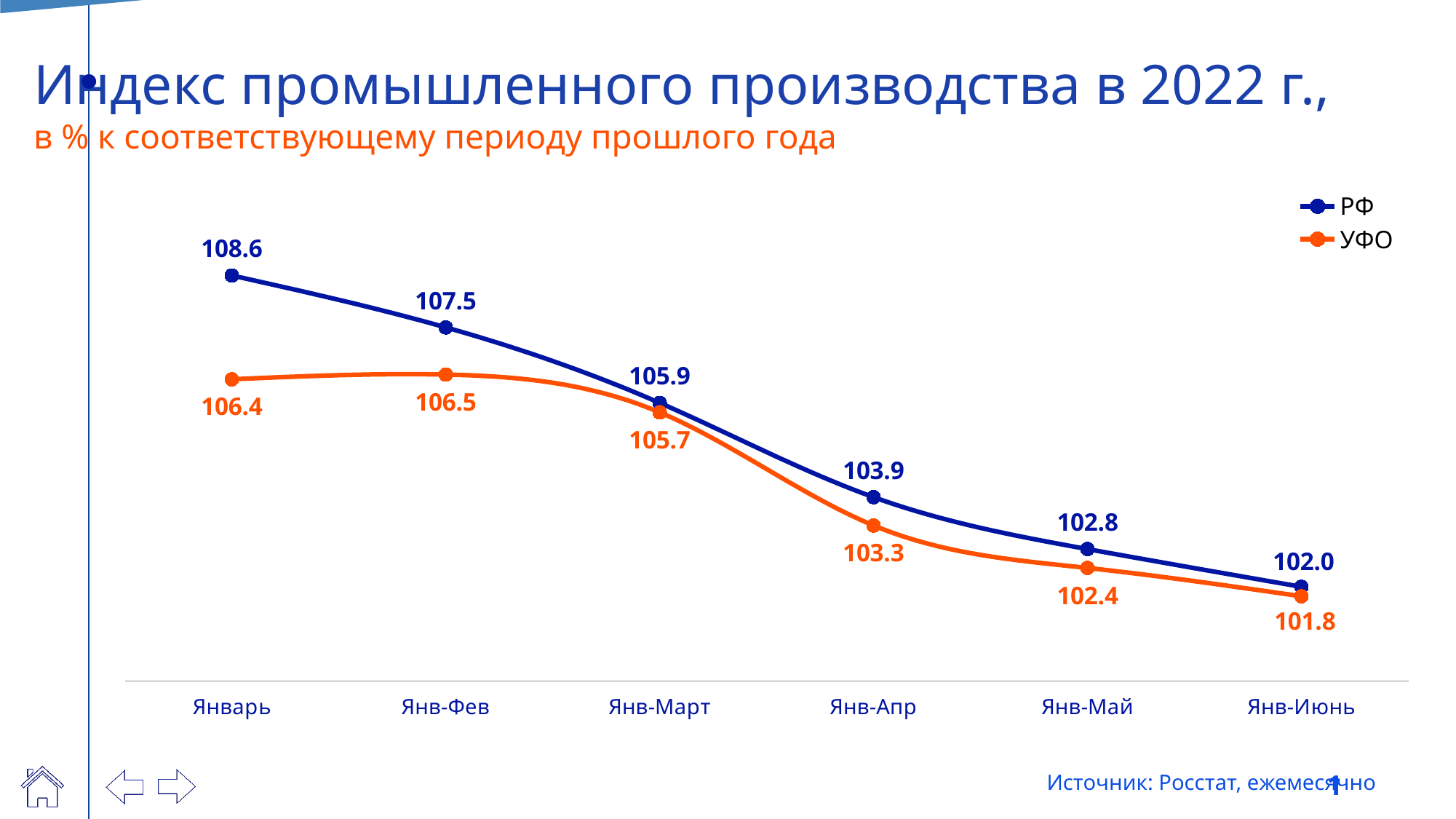
Which series has the larger value in Янв-Фев, РФ or УФО? РФ In which period is the РФ series highest? Январь What is the value for РФ in Янв-Май? 102.8 What kind of chart is shown on the slide? Line chart Does the РФ series rise or fall from Январь to Янв-Июнь? Fall What is the difference between РФ and УФО in Январь? 2.2 How many periods are shown on the x axis? 6 In which period is the УФО series lowest? Янв-Июнь What is the value for УФО in Янв-Апр? 103.3 How many series does the legend list? 2 What is the value for РФ in Январь? 108.6 What is the value for УФО in Янв-Июнь? 101.8